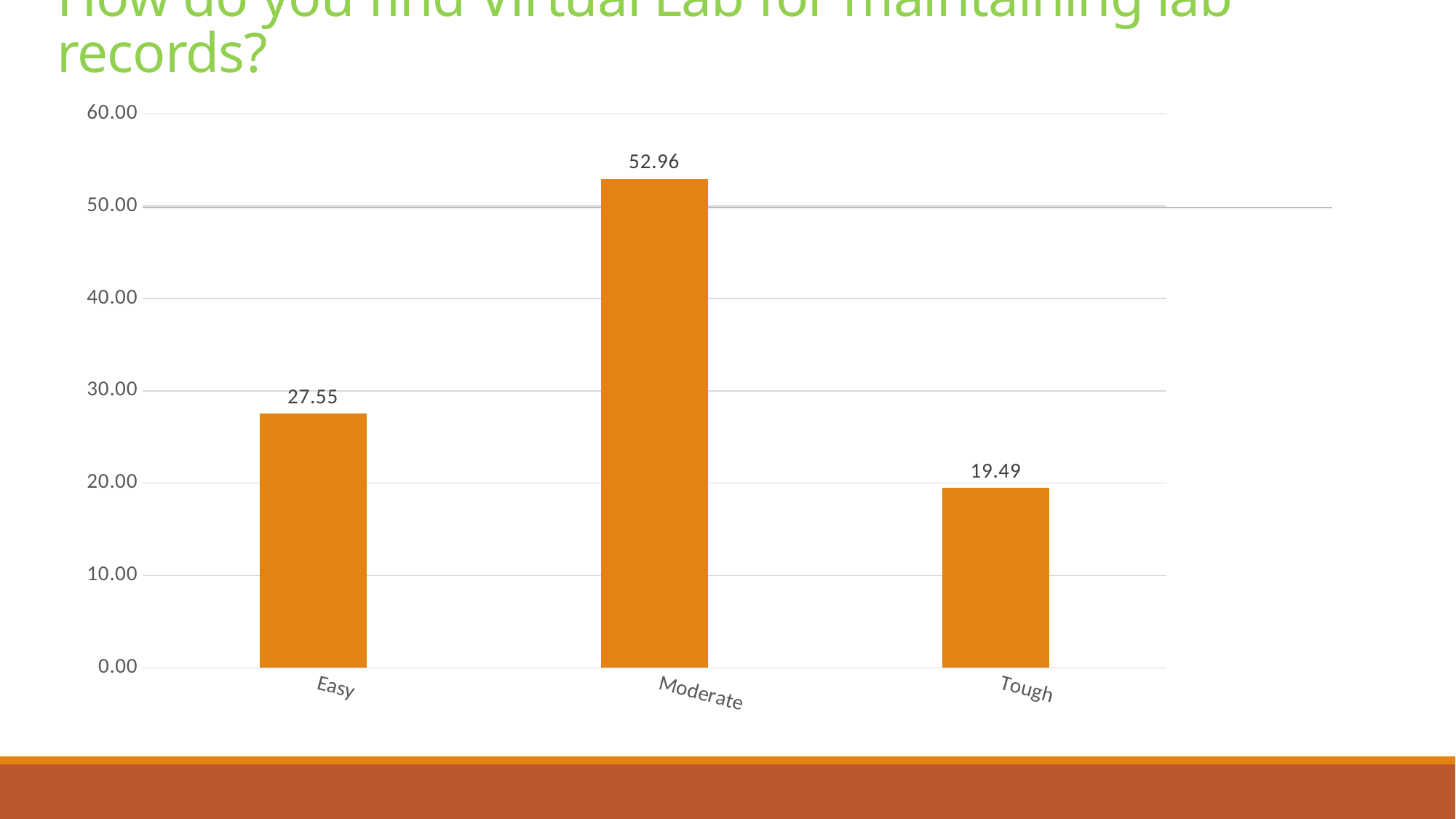
Is the value for Moderate greater or less than 50.00? greater What is the value for Easy? 27.55 What is the difference between the values for Easy and Tough? 8.06 What is the difference between the values for Moderate and Easy? 25.41 Which is larger, the value for Easy or the value for Tough? Easy What kind of chart is shown on the slide? bar chart What is the value for Moderate? 52.96 What is the value for Tough? 19.49 Which category has the highest value? Moderate What colour are the bars in the chart? orange How many categories are shown on the x axis? 3 Which category has the lowest value? Tough